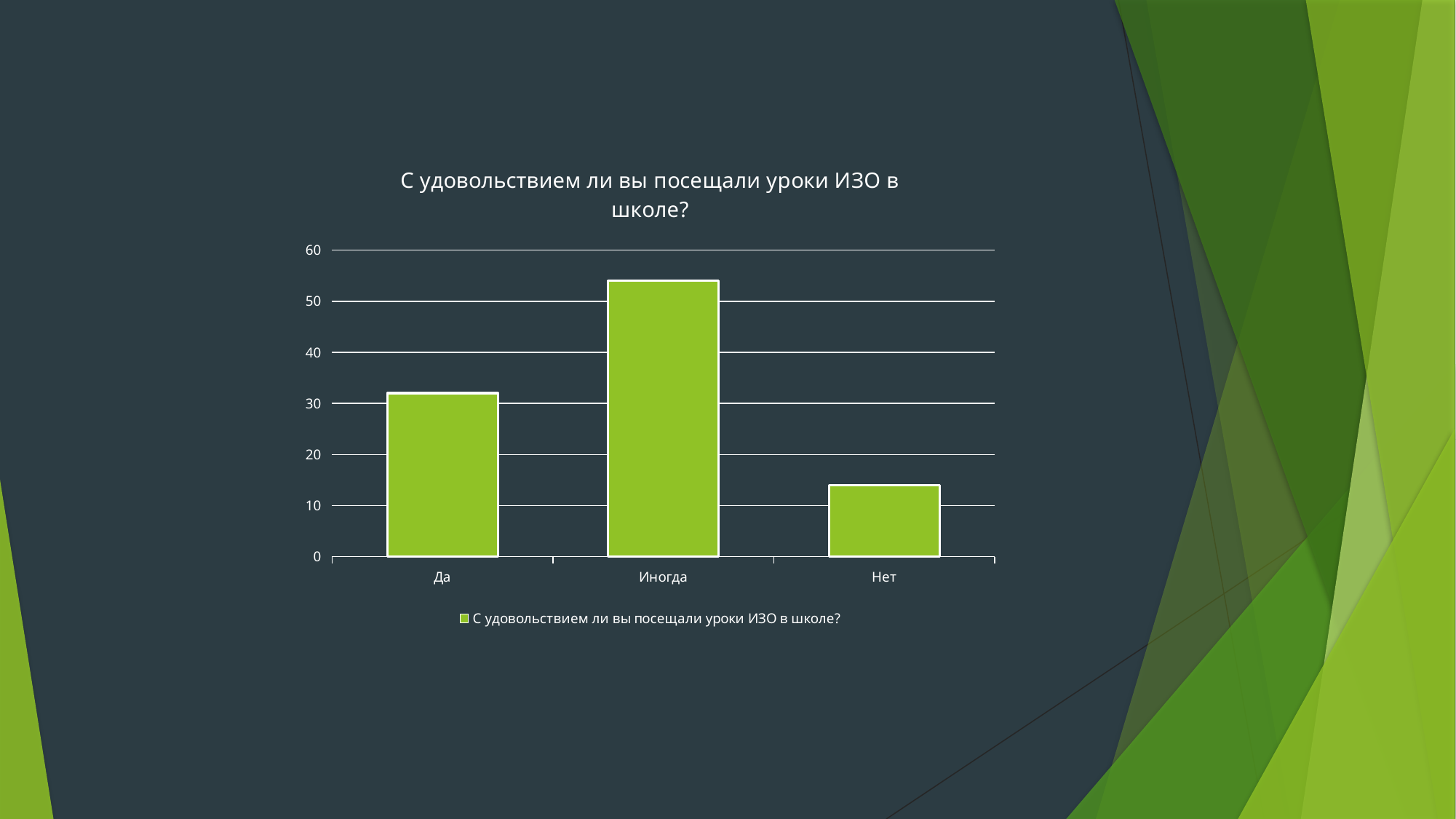
Is the value for Нет greater or less than 20? less What is the title of the chart? С удовольствием ли вы посещали уроки ИЗО в школе? Which is larger, the value for Да or the value for Нет? Да Is the value for Нет greater or less than 10? greater Is the value for Да greater or less than 40? less Which category has the lowest value? Нет How many series does the legend list? 1 What type of chart is shown on the slide? bar chart How many categories are shown on the x axis? 3 Which is larger, the value for Иногда or the value for Да? Иногда Which category has the highest value? Иногда